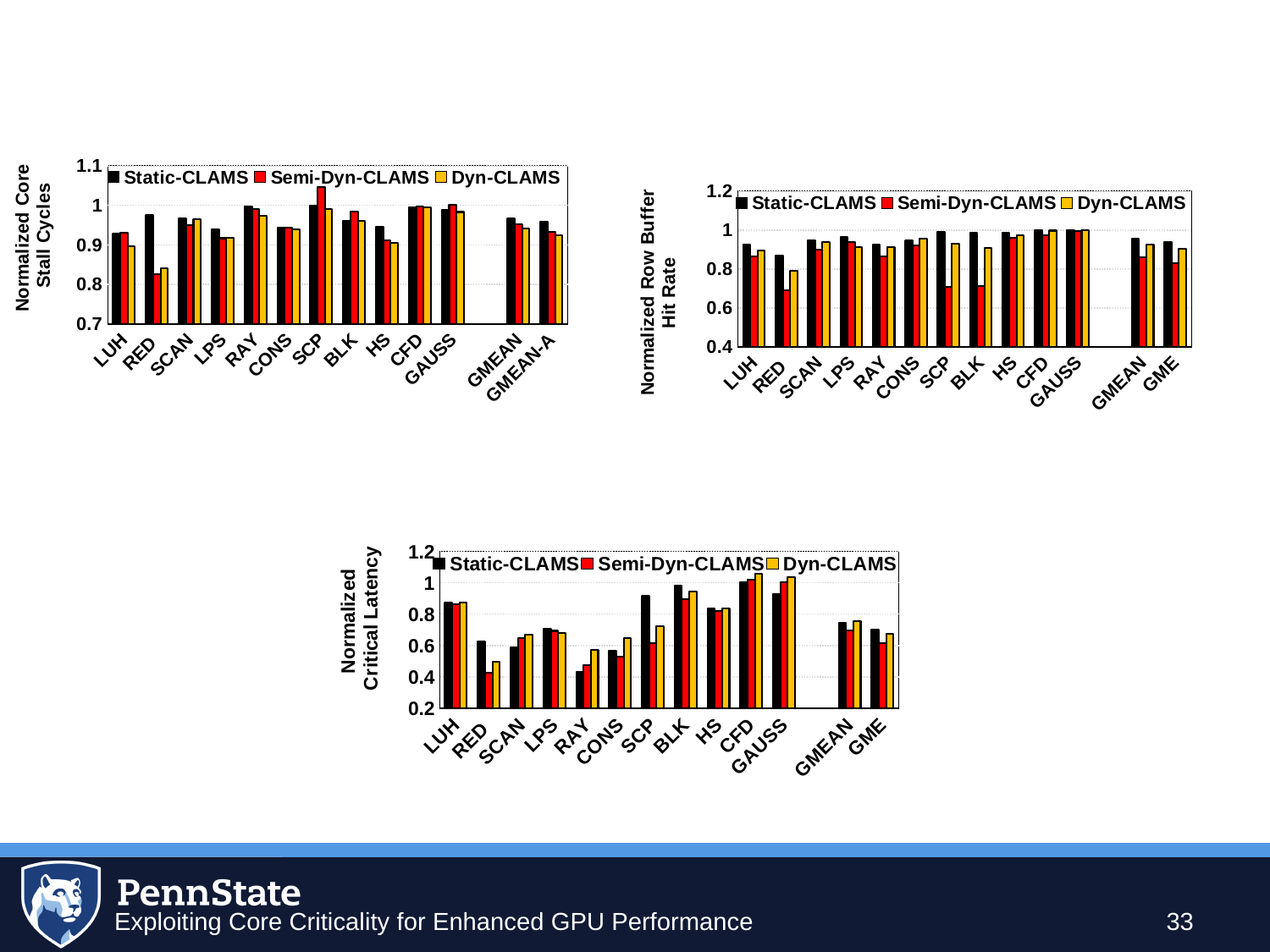
In the Normalized Core Stall Cycles chart, is the Semi-Dyn-CLAMS value for SCP greater or less than 1? greater In the Normalized Row Buffer Hit Rate chart, which is larger for RED: Static-CLAMS or Semi-Dyn-CLAMS? Static-CLAMS How many series does the legend of the Normalized Row Buffer Hit Rate chart list? 3 How many categories are shown on the x axis of the Normalized Critical Latency chart? 13 What are the three legend entries in the Normalized Critical Latency chart? Static-CLAMS, Semi-Dyn-CLAMS, Dyn-CLAMS What kind of chart is the Normalized Core Stall Cycles chart? bar chart In the Normalized Critical Latency chart, which category has the lowest Static-CLAMS value? RAY In the Normalized Core Stall Cycles chart, is the Semi-Dyn-CLAMS value for RED greater or less than 0.9? less In the Normalized Core Stall Cycles chart, which is larger for SCP: Static-CLAMS or Semi-Dyn-CLAMS? Semi-Dyn-CLAMS In the Normalized Critical Latency chart, is the Dyn-CLAMS value for CFD greater or less than 1? greater